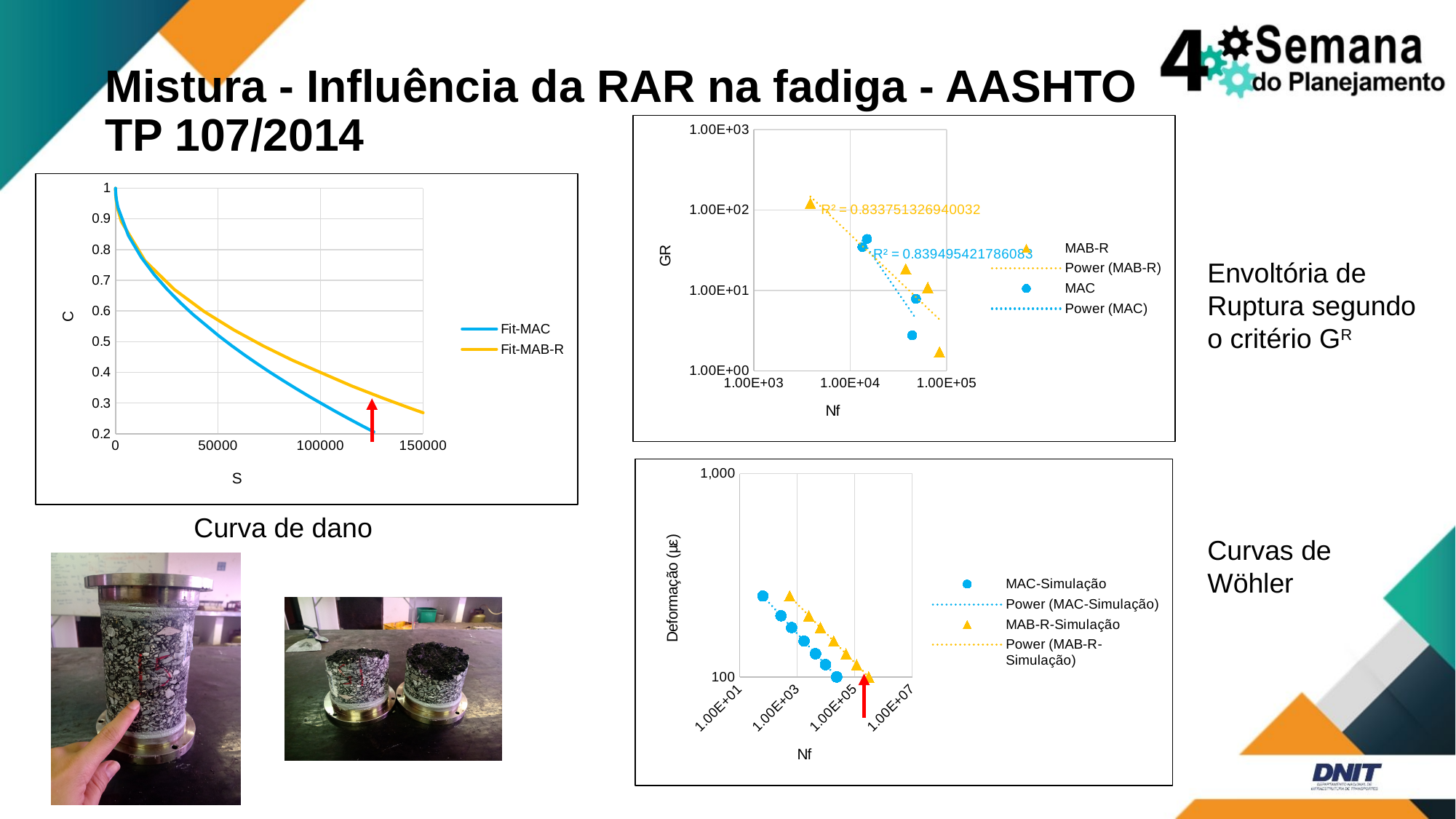
In the top-right chart (GR versus Nf), which trendline has the higher R², MAB-R or MAC? MAC In the top-right chart (GR versus Nf), how many entries does the legend list? 4 In the bottom-right chart (Curvas de Wöhler), does Deformação rise or fall as Nf increases? fall In the Curva de dano chart, do the values of C rise or fall as S increases? fall In the Curva de dano chart, how many series does the legend list? 2 In the Curva de dano chart, is the value of Fit-MAC at S = 100000 greater or less than 0.4? less What kind of chart is the Curva de dano chart? line chart In the Curva de dano chart, is the value of Fit-MAB-R at S = 150000 greater or less than 0.3? less In the top-right chart (GR versus Nf), what R² value is shown for the MAC power trendline? 0.839495421786083 In the Curva de dano chart, what are the two series named in the legend? Fit-MAC and Fit-MAB-R In the top-right chart (GR versus Nf), what R² value is shown for the MAB-R power trendline? 0.833751326940032 In the Curva de dano chart, which series has the higher value of C at S = 100000, Fit-MAC or Fit-MAB-R? Fit-MAB-R